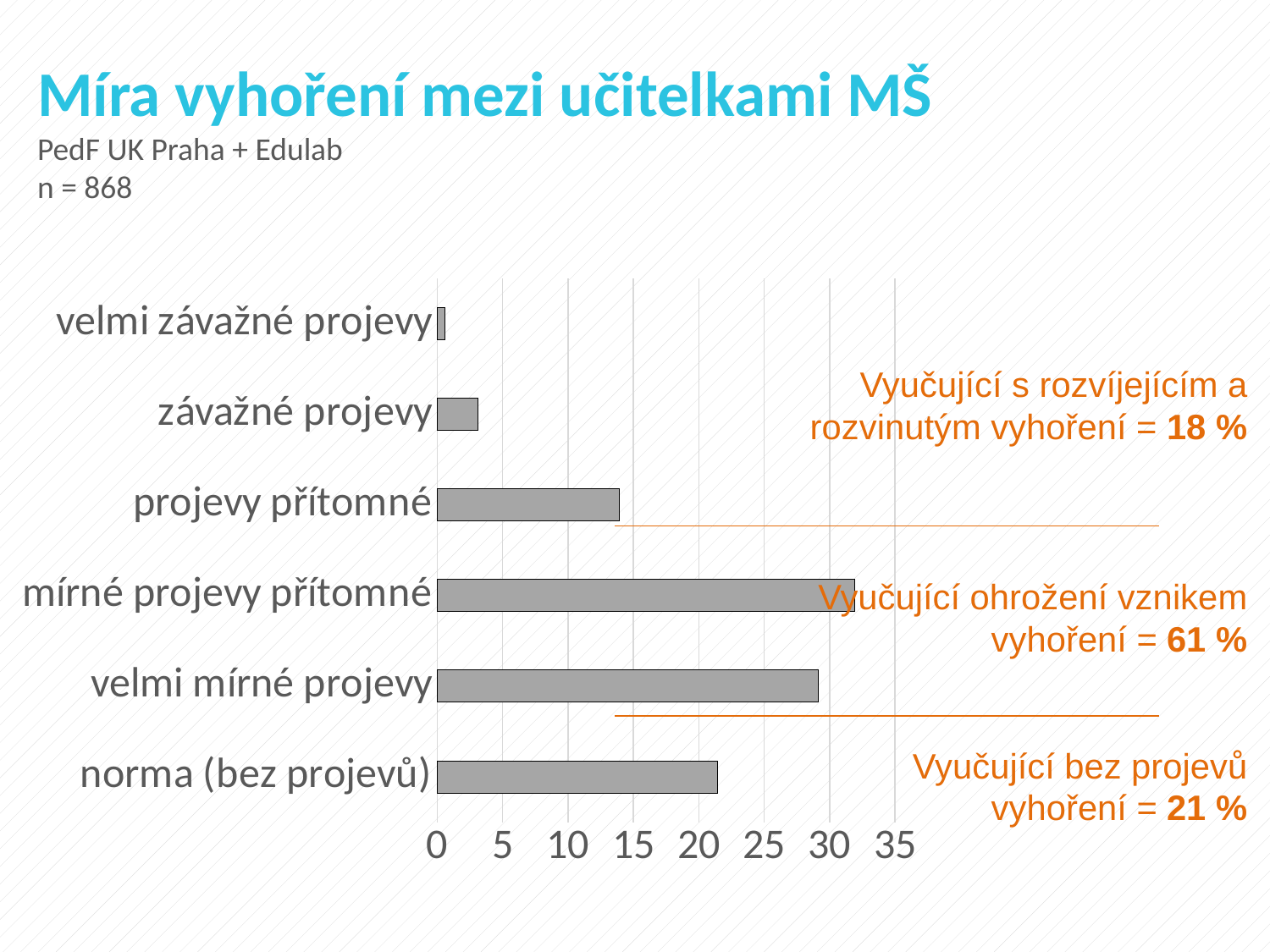
Is the value for 'norma (bez projevů)' greater or less than 20? greater What kind of chart is shown on the slide? bar chart Which category has the shortest bar? velmi závažné projevy Is the value for 'závažné projevy' greater or less than 5? less What is the title of the slide containing the chart? Míra vyhoření mezi učitelkami MŠ Which is larger, the value for 'projevy přítomné' or the value for 'závažné projevy'? projevy přítomné Is the value for 'velmi mírné projevy' greater or less than 25? greater How many categories are plotted in the chart? 6 Which is larger, the value for 'velmi mírné projevy' or the value for 'norma (bez projevů)'? velmi mírné projevy According to the annotation on the chart, what percentage of teachers are at risk of developing burnout (Vyučující ohrožení vznikem vyhoření)? 61 % Which category has the longest bar? mírné projevy přítomné